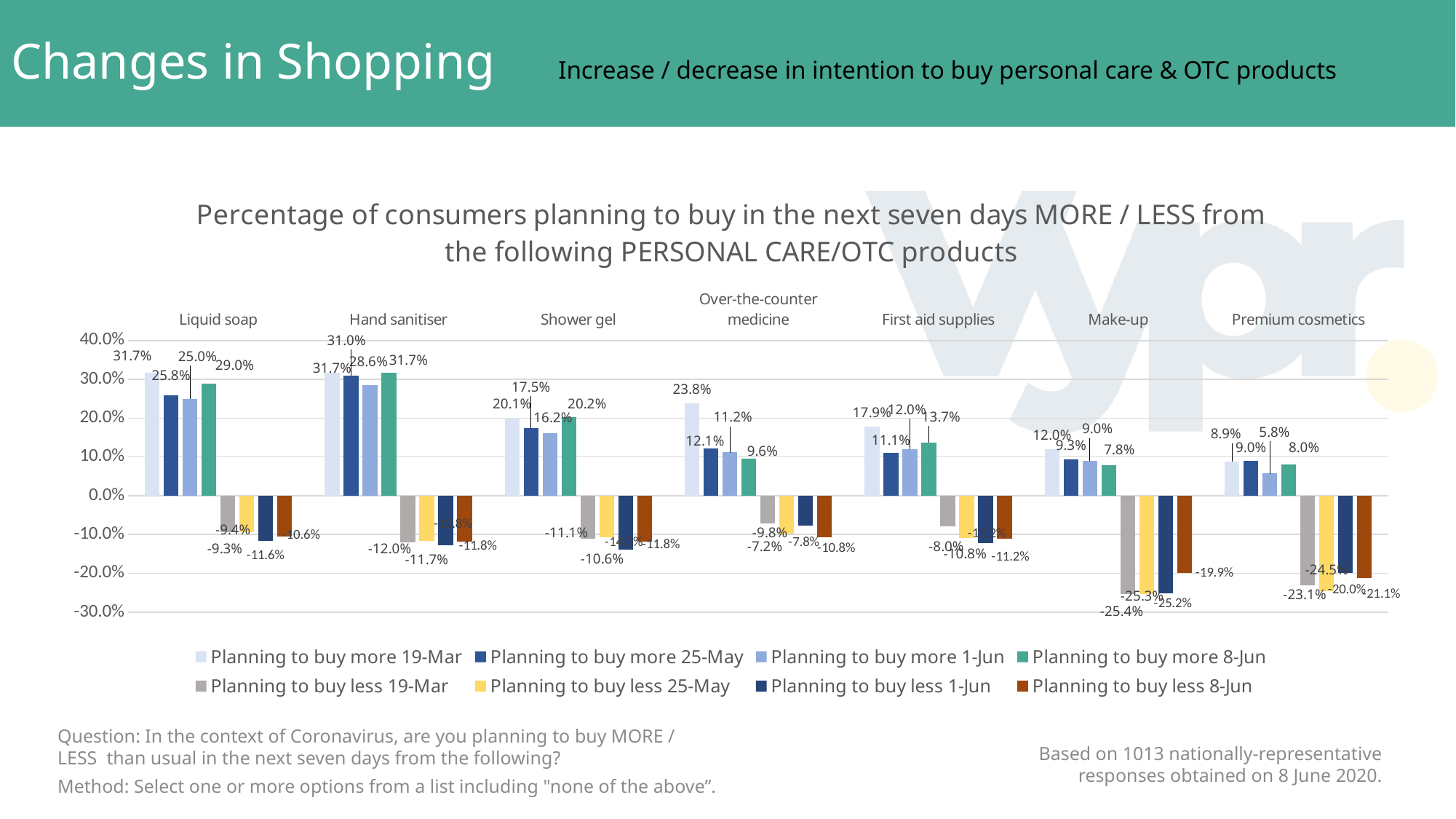
Is the value for Hand sanitiser in the 'Planning to buy less 1-Jun' series greater or less than -10.0%? less What is the value for Make-up in the 'Planning to buy less 8-Jun' series? -19.9% For Liquid soap, what is the difference between 'Planning to buy more 19-Mar' (31.7%) and 'Planning to buy more 8-Jun' (29.0%)? 2.7 percentage points What kind of chart is shown on the slide? Bar chart What is the value for Over-the-counter medicine in the 'Planning to buy more 19-Mar' series? 23.8% What is the subtitle shown in the header bar to the right of 'Changes in Shopping'? Increase / decrease in intention to buy personal care & OTC products What is the value for Make-up in the 'Planning to buy more 8-Jun' series? 7.8% Which category has the lowest value in the 'Planning to buy more 1-Jun' series? Premium cosmetics Which category has the highest value in the 'Planning to buy more 8-Jun' series? Hand sanitiser In the 'Planning to buy more 19-Mar' series, which is larger: Make-up or Premium cosmetics? Make-up How many product categories are shown on the x axis? 7 How many series does the legend list? 8